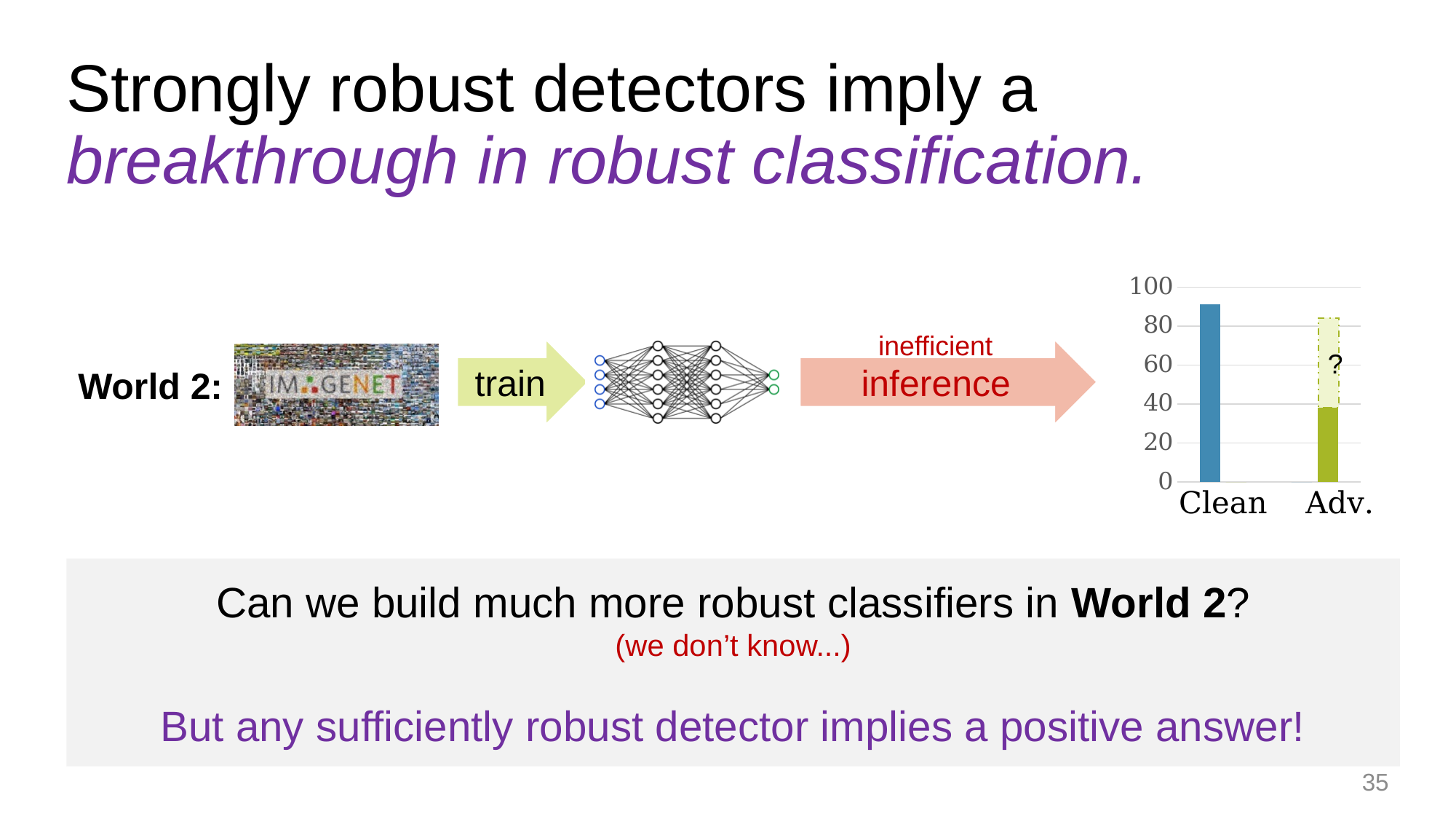
What is the highest tick value shown on the y axis of the chart? 100 What kind of chart is shown on the right of the slide? bar chart How many categories are shown on the x axis of the bar chart? 2 Do the solid bar values rise or fall from Clean to Adv.? fall Which solid bar is larger, Clean or Adv.? Clean Is the value of the solid Adv. bar greater or less than 60? less Is the value of the Clean bar greater or less than 60? greater Which category has the tallest solid bar in the chart? Clean What symbol is printed inside the dashed extension of the Adv. bar? ? Is the value of the Clean bar greater or less than 80? greater Which category has the shortest solid bar in the chart? Adv.